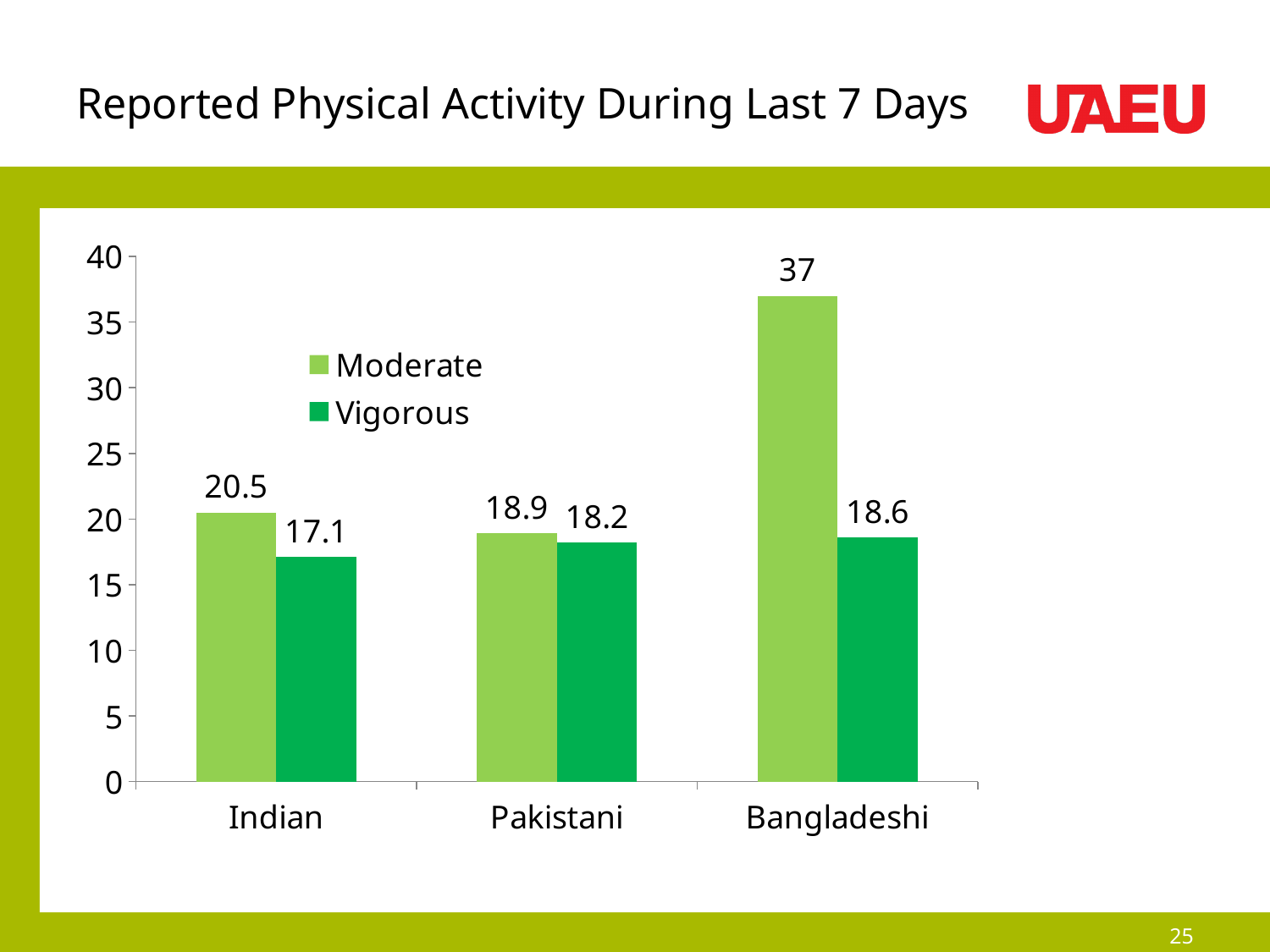
What is the Vigorous value for Bangladeshi? 18.6 Is the Moderate value for Bangladeshi greater or less than 35? greater Which category has the lowest Vigorous value? Indian What is the difference between the Moderate and Vigorous values for Bangladeshi? 18.4 What is the difference between the Moderate values for Indian and Pakistani? 1.6 How many series does the legend list? 2 What is the Moderate value for Indian? 20.5 Which is larger, the Vigorous value for Pakistani or the Vigorous value for Indian? Pakistani What is the Moderate value for Pakistani? 18.9 Which category has the highest Moderate value? Bangladeshi What kind of chart is shown on the slide? bar chart How many categories are shown on the x axis? 3